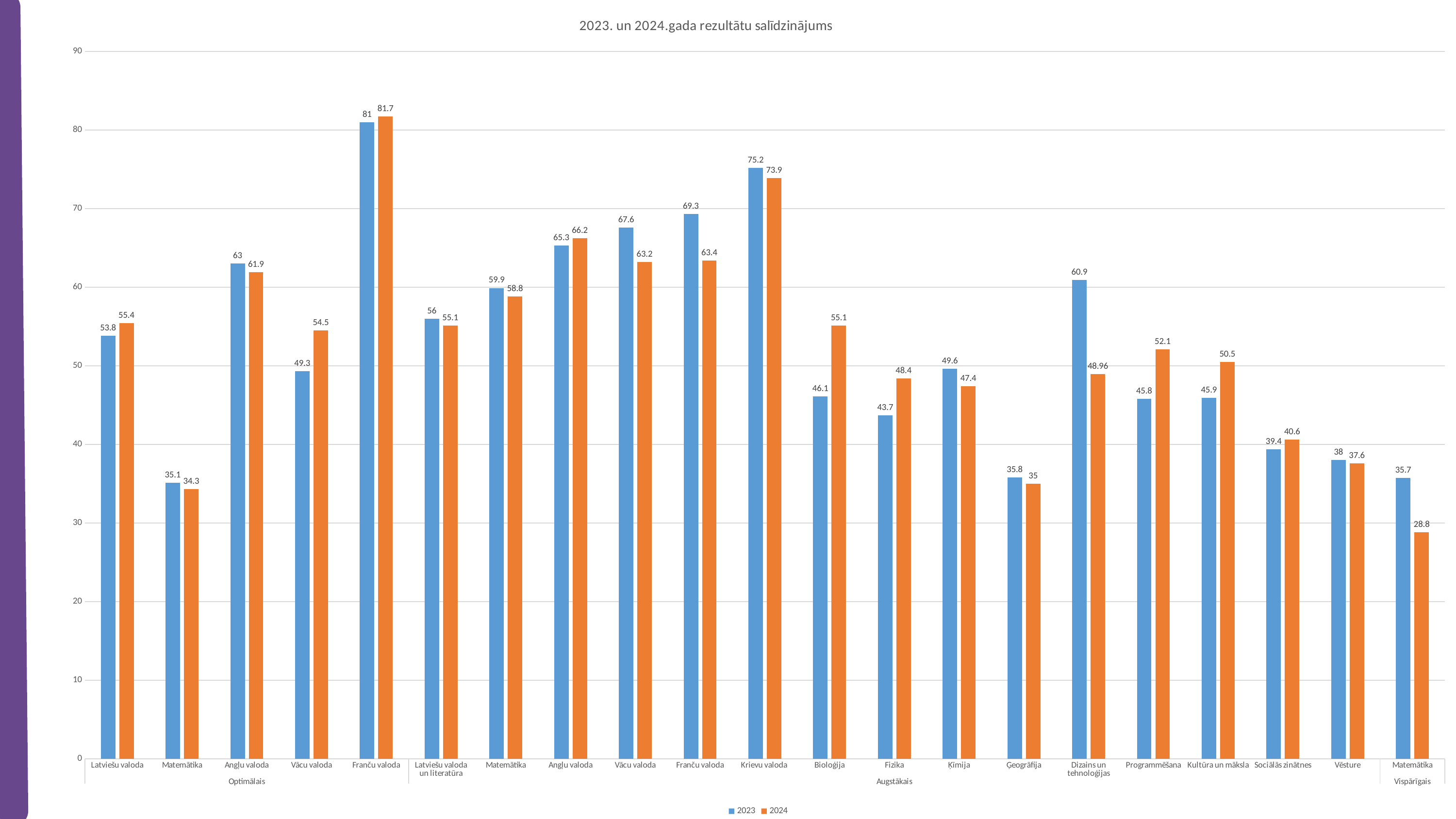
How many series does the legend list? 2 What is the 2023 value for Krievu valoda in the Augstākais group? 75.2 Is the 2024 value for Programmēšana greater or less than 50? greater What kind of chart is shown on the slide? bar chart Which category has the highest 2023 value? Franču valoda (Optimālais) What is the title of the chart? 2023. un 2024.gada rezultātu salīdzinājums What is the difference between the 2023 and 2024 values for Bioloģija? 9 What is the 2024 value for Dizains un tehnoloģijas? 48.96 For Vācu valoda in the Augstākais group, which year has the larger value, 2023 or 2024? 2023 Which category has the lowest 2024 value? Matemātika (Vispārīgais) How many categories are shown on the x axis? 21 What is the 2024 value for Franču valoda in the Optimālais group? 81.7